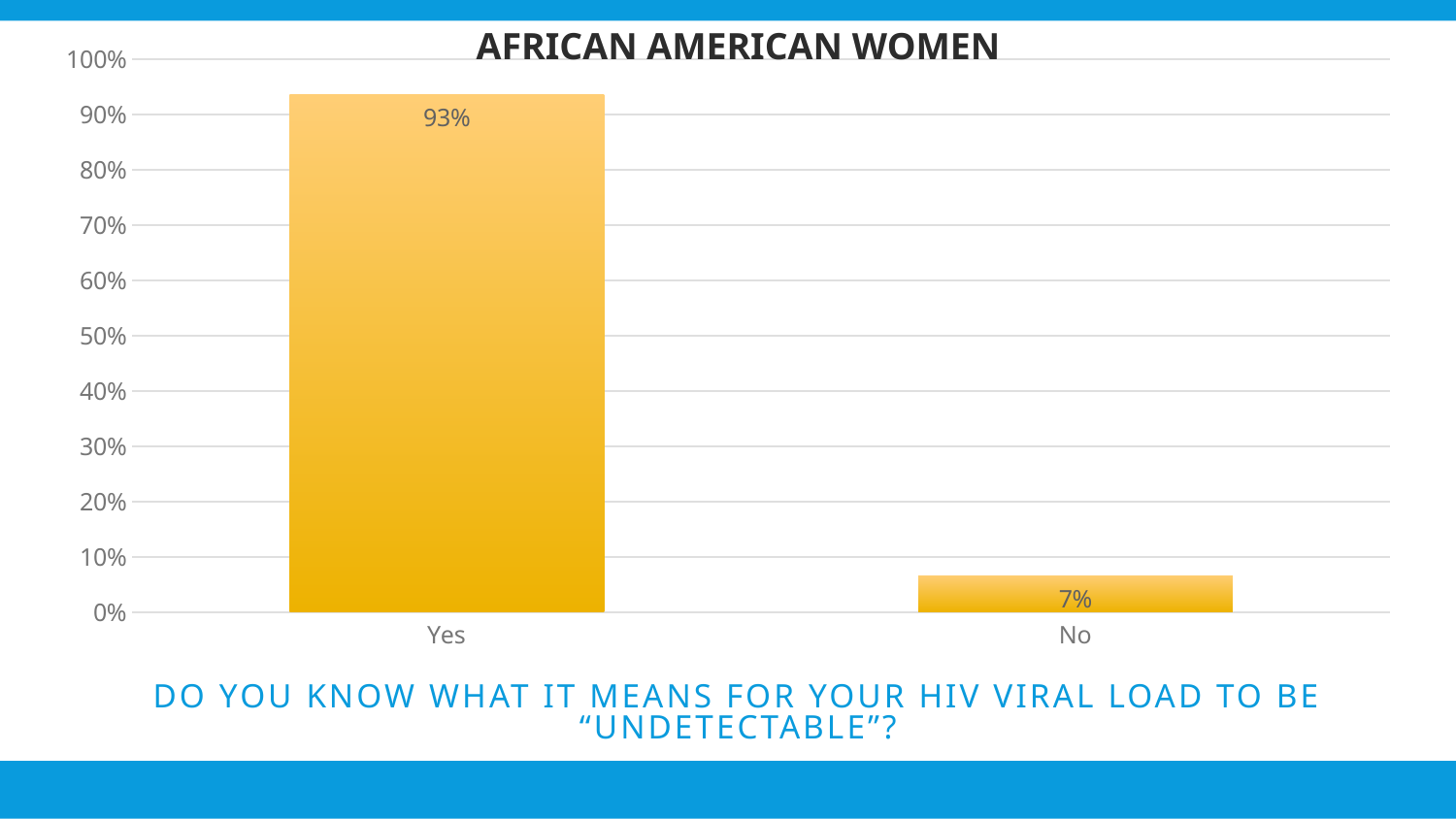
Which is larger, the value for "Yes" or the value for "No"? Yes What is the difference in percentage points between the "Yes" and "No" responses? 86 Is the value for "Yes" greater or less than 90%? greater What is the maximum value shown on the y axis? 100% What percentage of African American women answered "No"? 7% What percentage of African American women answered "Yes"? 93% Which response category has the lowest value? No How many response categories are shown on the x axis? 2 Which response category has the highest value? Yes What kind of chart is shown on the slide? Bar chart Is the value for "No" greater or less than 10%? less What is the title of the chart? AFRICAN AMERICAN WOMEN